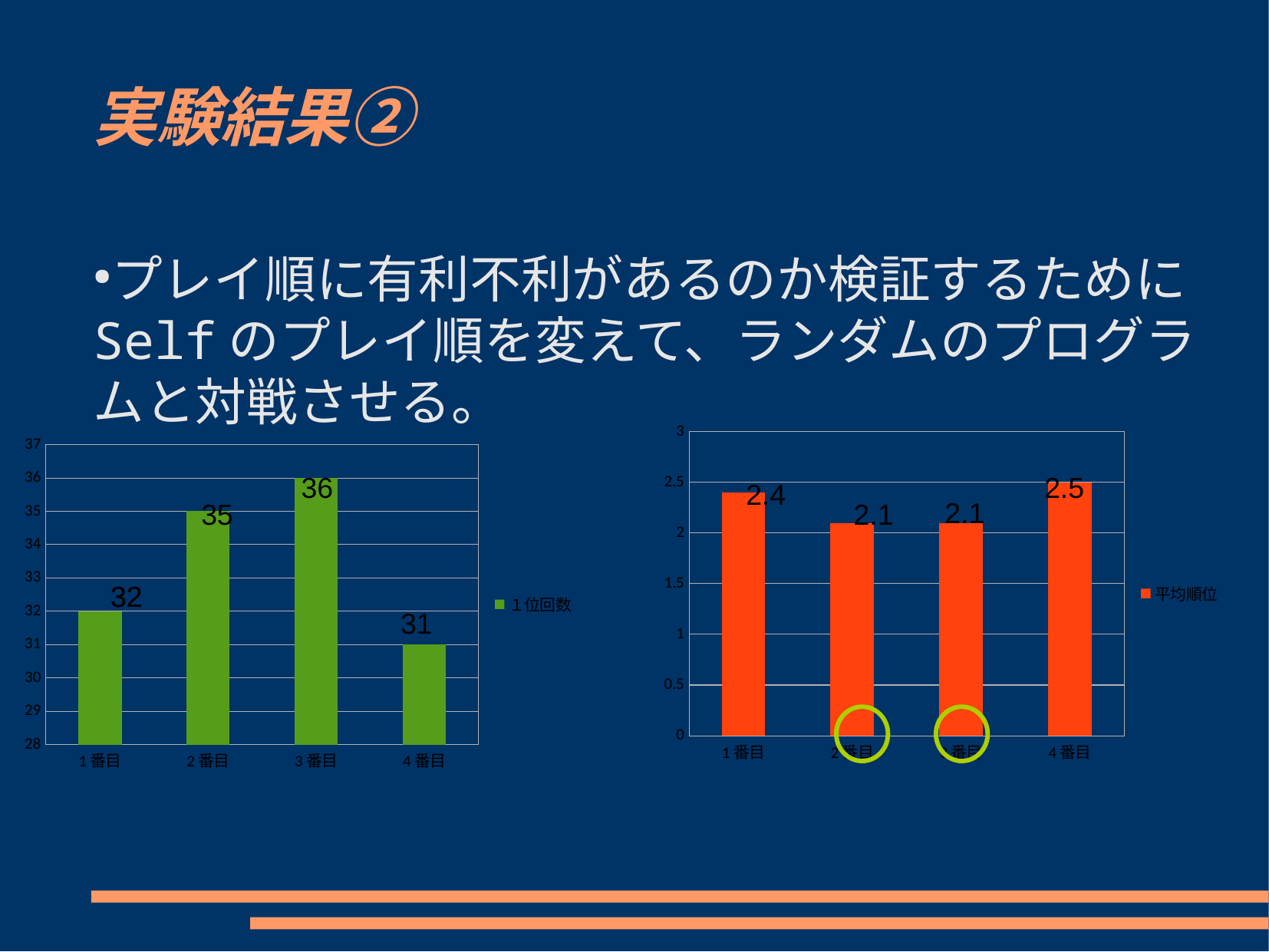
In the left chart (1位回数), which category has the lowest value? 4番目 In the left chart (1位回数), what is the difference between the values for 3番目 and 4番目? 5 In the left chart (1位回数), which category has the highest value? 3番目 In the left chart (1位回数), what is the value for 3番目? 36 In the right chart (平均順位), what is the value for 4番目? 2.5 In the right chart (平均順位), what is the difference between the values for 4番目 and 2番目? 0.4 In the left chart (1位回数), which is larger, the value for 1番目 or 2番目? 2番目 In the left chart (1位回数), what is the value for 4番目? 31 How many categories are shown on the x axis of the right chart (平均順位)? 4 In the right chart (平均順位), which category has the highest value? 4番目 What kind of chart is the left chart (1位回数)? Bar chart In the right chart (平均順位), what is the value for 1番目? 2.4